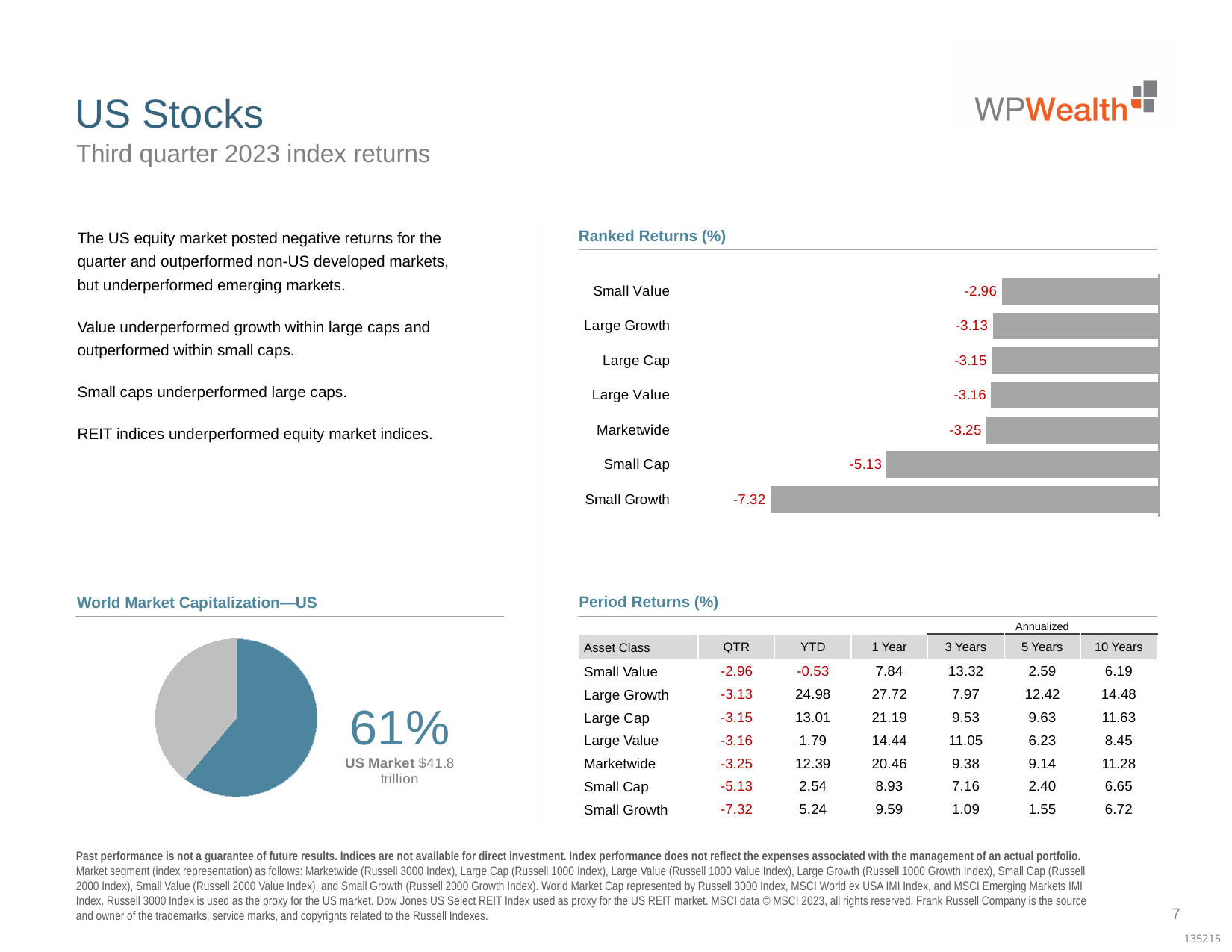
In the Ranked Returns (%) chart, which category has the lowest value? Small Growth In the Ranked Returns (%) chart, what is the value for Marketwide? -3.25 How many categories are shown in the Ranked Returns (%) chart? 7 In the World Market Capitalization—US chart, what is the US Market value in trillions shown next to the pie? $41.8 trillion In the Ranked Returns (%) chart, what is the value for Small Cap? -5.13 In the World Market Capitalization—US chart, what share of the pie does the US Market represent? 61% In the Ranked Returns (%) chart, what is the value for Small Growth? -7.32 In the Ranked Returns (%) chart, which is larger, the value for Small Cap or the value for Small Growth? Small Cap What kind of chart is the World Market Capitalization—US chart? Pie chart What kind of chart is the Ranked Returns (%) chart? Bar chart In the Ranked Returns (%) chart, which category has the highest value? Small Value In the Ranked Returns (%) chart, what is the difference between the values for Small Cap and Small Growth? 2.19